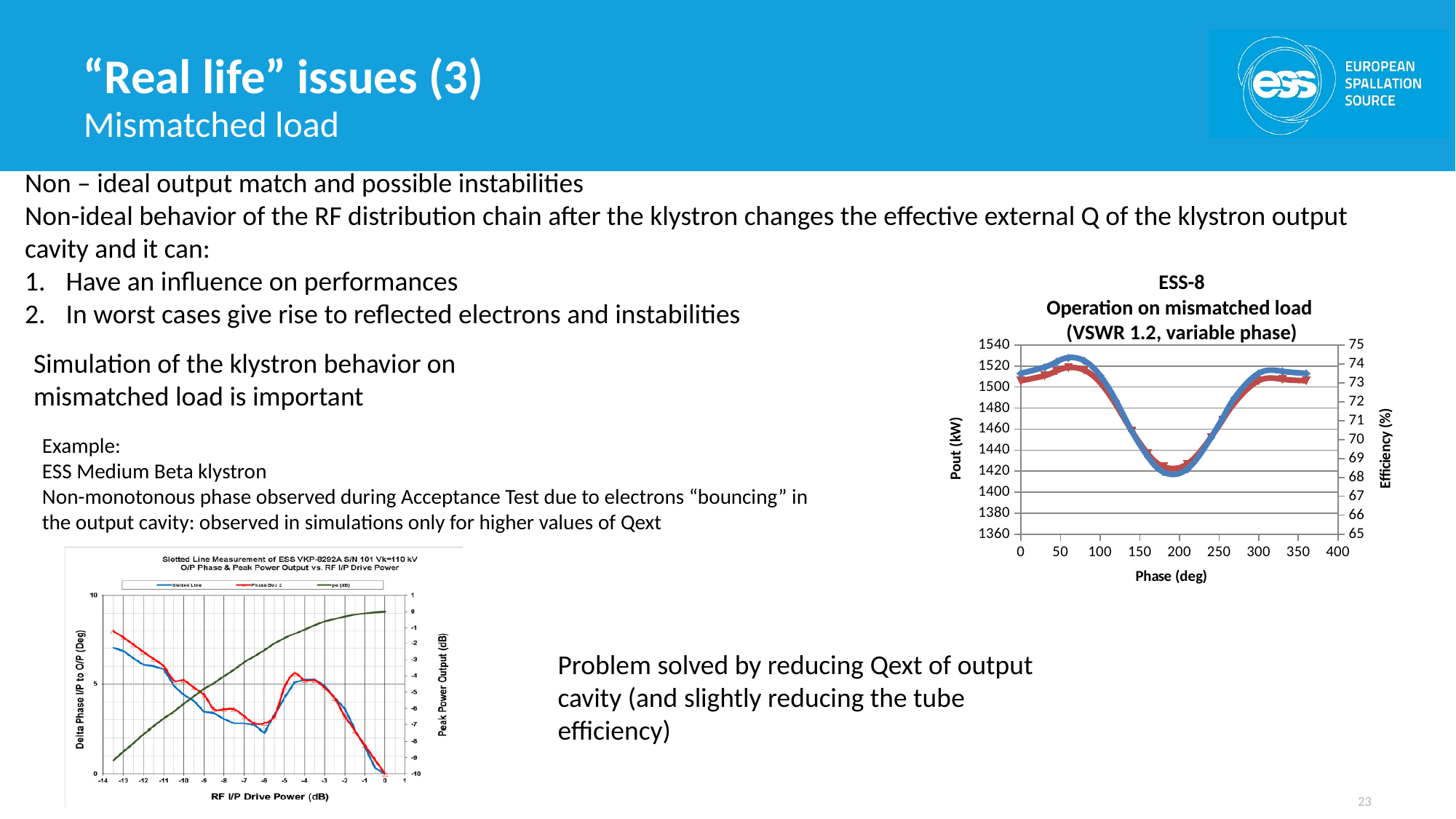
In the ESS-8 chart, is the Pout value at a phase of 200 deg greater or less than 1440? less In the ESS-8 chart, does Pout rise or fall as the phase goes from 100 deg to 200 deg? fall What is the highest tick value on the right-hand Efficiency (%) axis of the ESS-8 chart? 75 In the bottom-left 'Slotted Line Measurement' chart, does the green po (dB) line rise or fall as RF I/P Drive Power increases from -14 dB to 0 dB? rise What kind of chart is the bottom-left 'Slotted Line Measurement' chart? line chart What kind of chart is the ESS-8 'Operation on mismatched load' chart? line chart In the ESS-8 chart, does Pout rise or fall as the phase goes from 200 deg to 300 deg? rise In the ESS-8 chart, is the Pout value at a phase of 50 deg greater or less than 1500? greater How many series does the legend of the bottom-left 'Slotted Line Measurement' chart list? 3 What is the label of the x axis of the ESS-8 chart? Phase (deg) In the bottom-left 'Slotted Line Measurement' chart, is the Delta Phase value of the Slotted Line series at -13 dB drive power greater or less than 5? greater In the ESS-8 chart, is Pout higher at a phase of 50 deg or at a phase of 200 deg? 50 deg